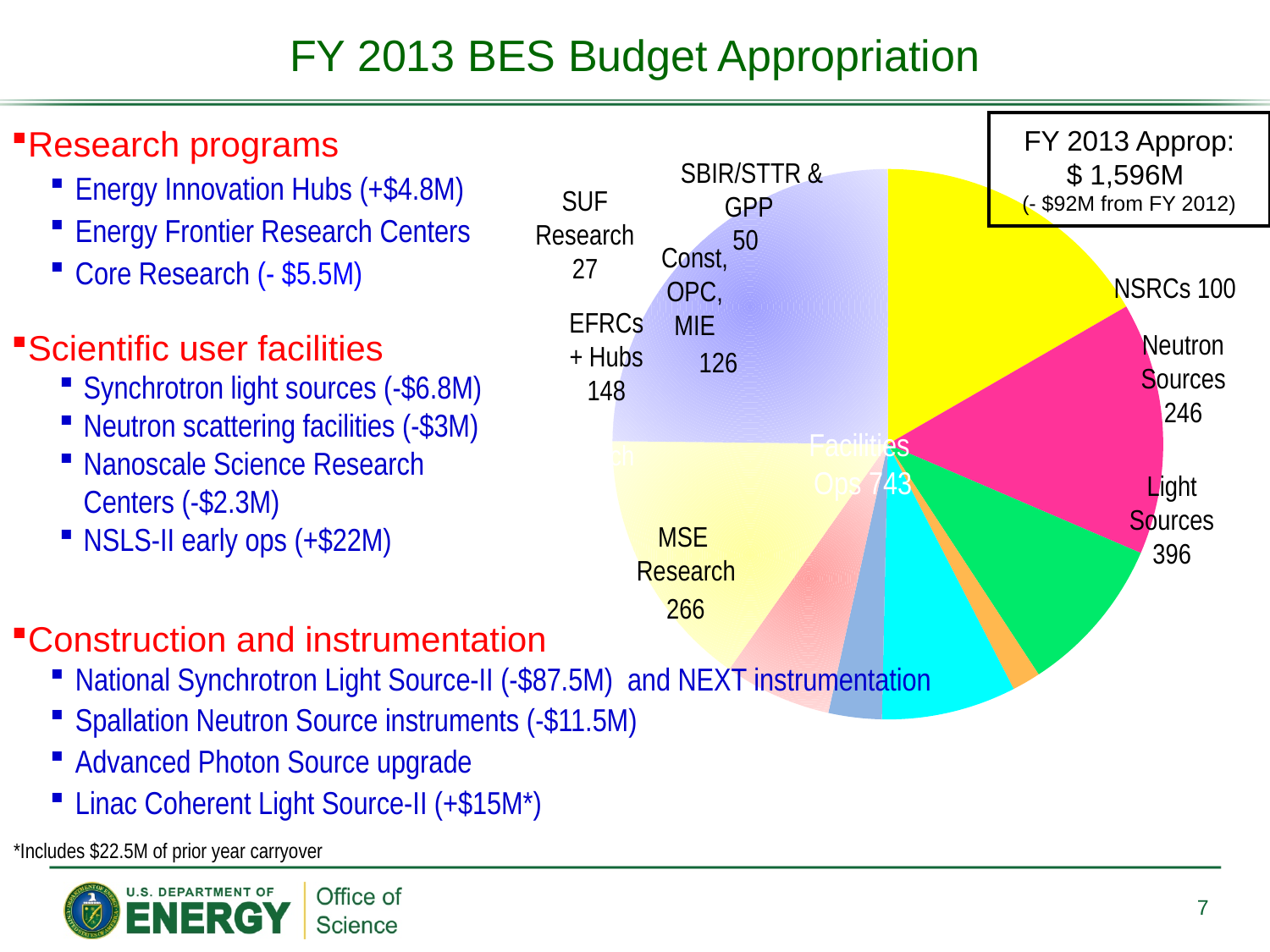
Which labeled category in the pie chart has the largest value? Facilities Ops What is the value shown for Neutron Sources in the pie chart? 246 What is the value shown for EFRCs + Hubs in the pie chart? 148 What kind of chart is shown on the slide? Pie chart Which labeled category in the pie chart has the smallest value? SUF Research What is the value shown for NSRCs in the pie chart? 100 What is the value shown for SBIR/STTR & GPP in the pie chart? 50 Which is larger in the pie chart, MSE Research or EFRCs + Hubs? MSE Research What is the value shown for MSE Research in the pie chart? 266 What total FY 2013 appropriation is stated in the box next to the pie chart? $ 1,596M What is the difference between the Light Sources value and the Neutron Sources value in the pie chart? 150 What is the value shown for Light Sources in the pie chart? 396